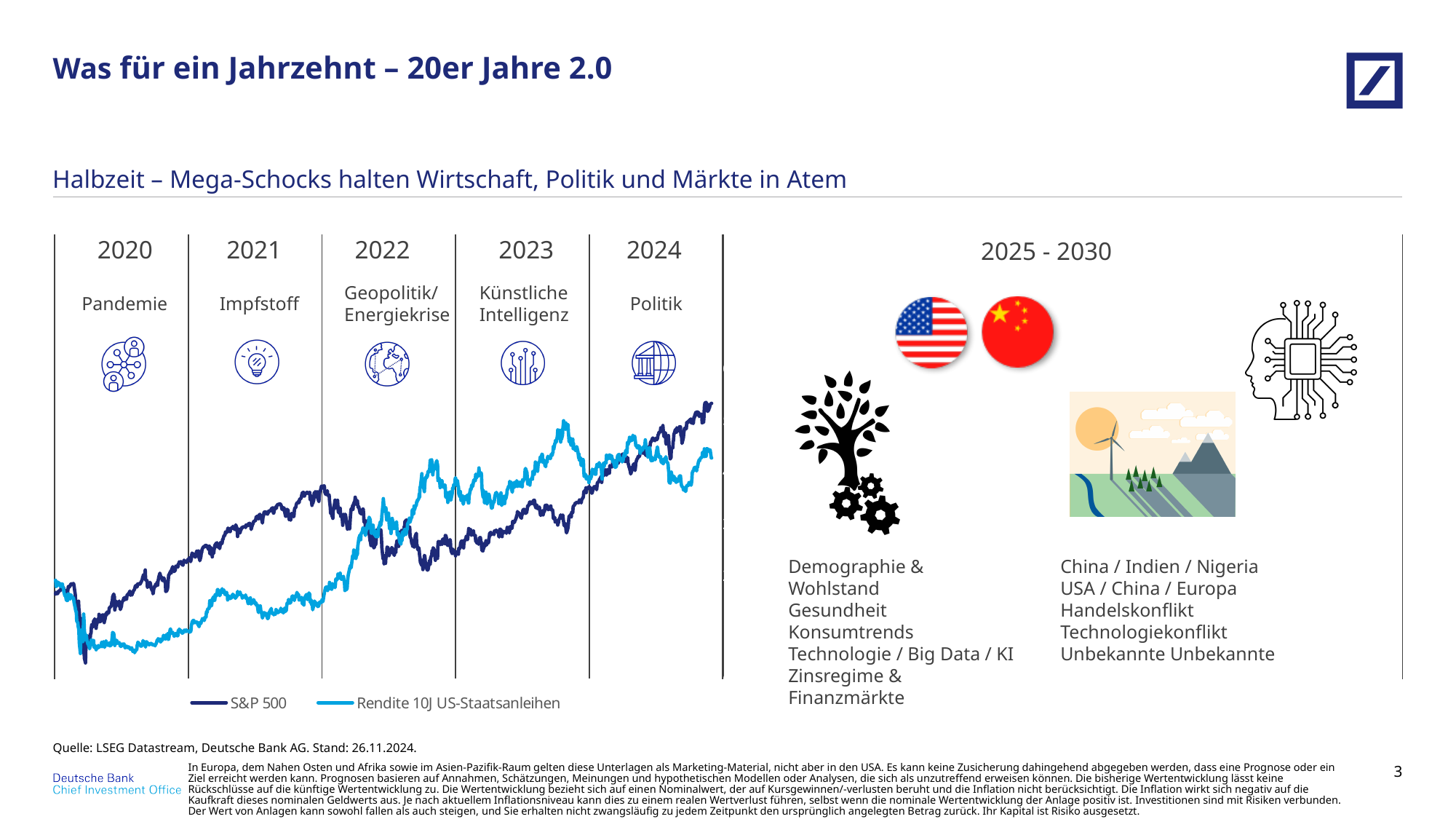
What kind of chart is shown on the left of the slide? line chart Which series is higher at the end of 2024, S&P 500 or Rendite 10J US-Staatsanleihen? S&P 500 Does the S&P 500 line rise or fall overall from 2020 to the end of 2024? rise Which series is lower at the end of 2024? Rendite 10J US-Staatsanleihen Which year in the chart is labelled "Pandemie"? 2020 How many years are labelled along the top of the chart? 5 What are the two series named in the chart legend? S&P 500 and Rendite 10J US-Staatsanleihen Does the Rendite 10J US-Staatsanleihen line rise or fall overall from 2020 to 2022? rise Which series is higher at the start of 2021, S&P 500 or Rendite 10J US-Staatsanleihen? S&P 500 How many series does the legend of the chart list? 2 Which series reaches the highest point on the chart? S&P 500